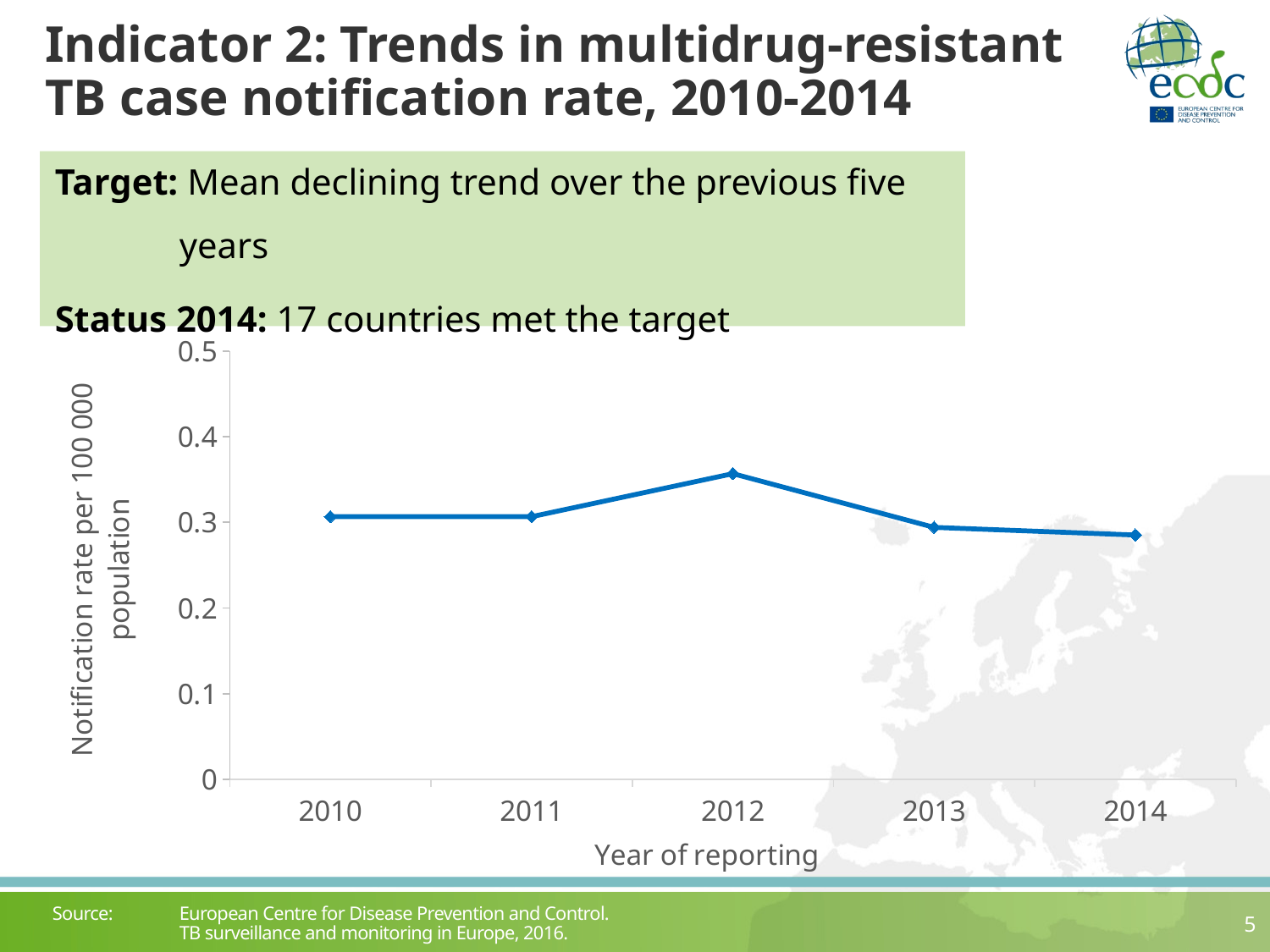
Is the notification rate for 2010 greater or less than 0.2? greater Is the notification rate for 2012 greater or less than 0.3? greater Is the notification rate for 2014 greater or less than 0.3? less What kind of chart is shown on the slide? line chart Which year has the highest notification rate in the chart? 2012 Which is larger, the notification rate for 2012 or for 2014? 2012 What is the label of the x axis of the chart? Year of reporting What is the label of the y axis of the chart? Notification rate per 100 000 population How many years are plotted on the x axis of the chart? 5 Between 2012 and 2014, do the notification rates rise or fall? fall